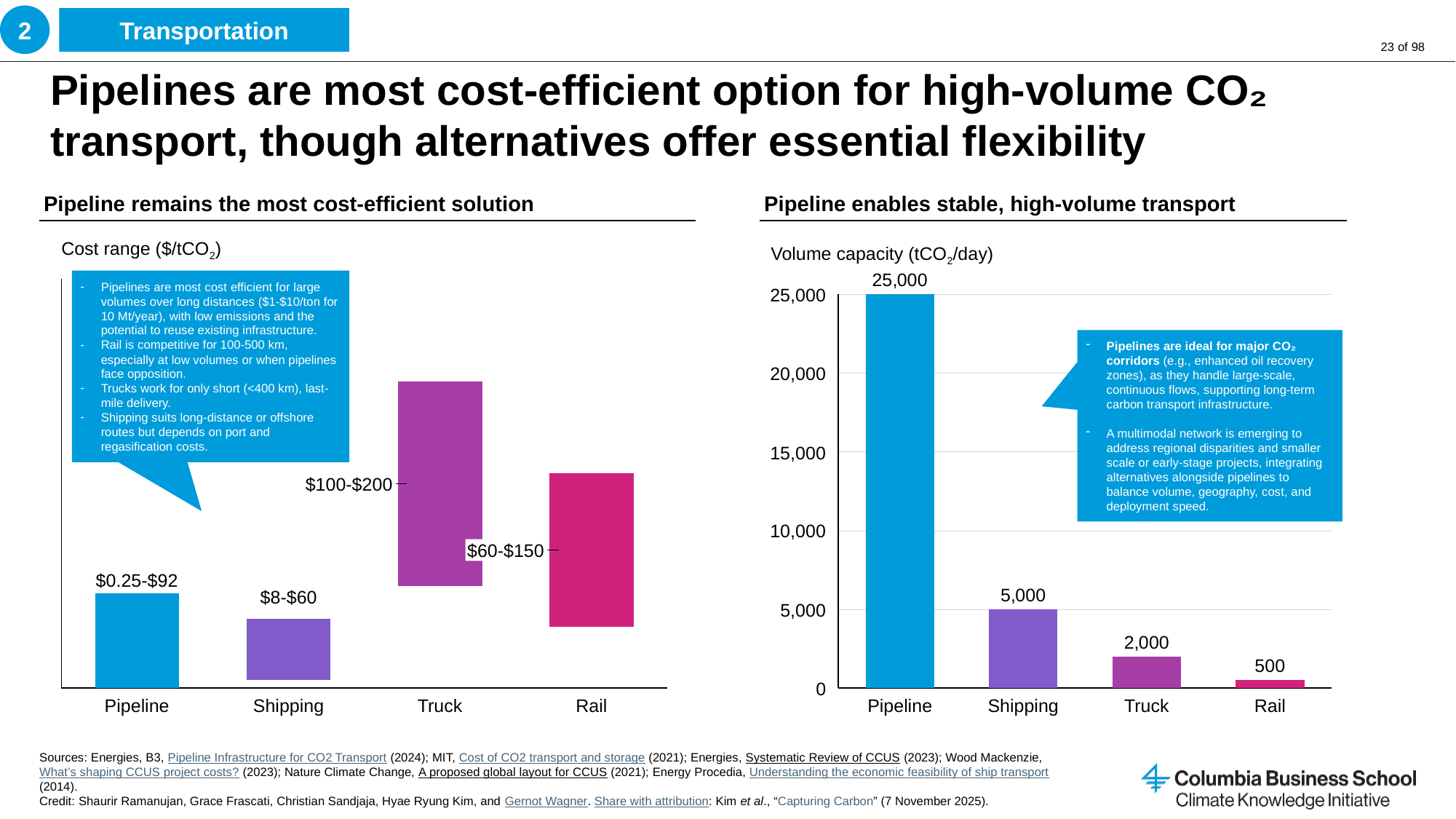
In the 'Pipeline remains the most cost-efficient solution' chart, what is the cost range for Pipeline? $0.25-$92 What kind of chart is the 'Pipeline enables stable, high-volume transport' chart? bar chart In the 'Pipeline enables stable, high-volume transport' chart, what is the difference in volume capacity between Shipping and Truck? 3,000 In the 'Pipeline remains the most cost-efficient solution' chart, what is the cost range for Rail? $60-$150 In the 'Pipeline enables stable, high-volume transport' chart, do the values rise or fall from left to right along the x axis? fall In the 'Pipeline enables stable, high-volume transport' chart, what is the volume capacity for Pipeline? 25,000 In the 'Pipeline remains the most cost-efficient solution' chart, what is the cost range for Truck? $100-$200 In the 'Pipeline enables stable, high-volume transport' chart, which category has the lowest volume capacity? Rail In the 'Pipeline enables stable, high-volume transport' chart, what is the volume capacity for Truck? 2,000 In the 'Pipeline enables stable, high-volume transport' chart, what is the difference in volume capacity between Pipeline and Rail? 24,500 In the 'Pipeline enables stable, high-volume transport' chart, which category has the highest volume capacity? Pipeline How many categories are shown in the 'Pipeline remains the most cost-efficient solution' chart? 4